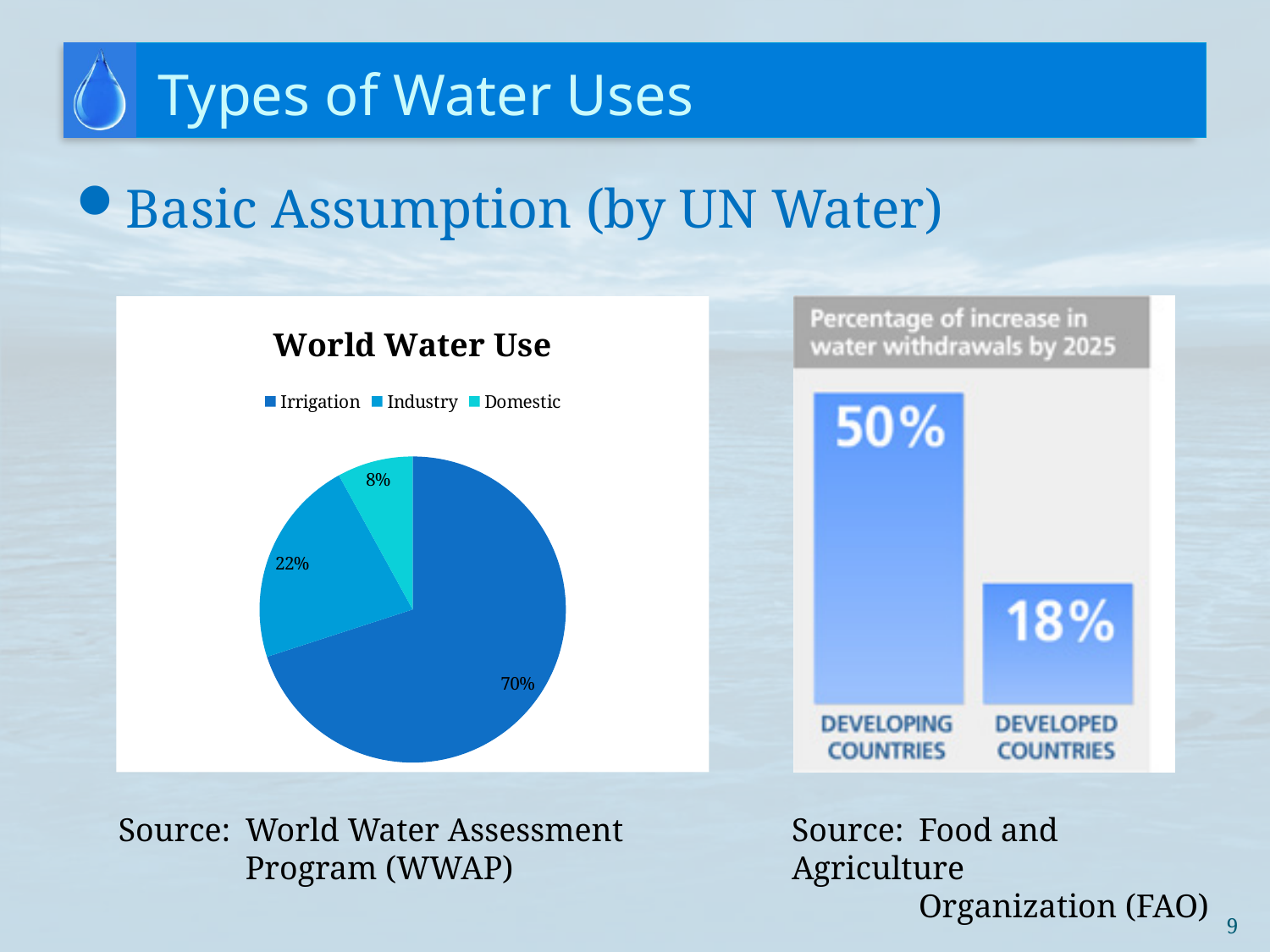
In the Percentage of increase in water withdrawals by 2025 chart, what is the difference between Developing Countries and Developed Countries? 32% In the World Water Use chart, what percentage of water use is Domestic? 8% What kind of chart is the Percentage of increase in water withdrawals by 2025 chart? Bar chart In the World Water Use chart, which category has the smallest share? Domestic In the World Water Use chart, which category has the largest share? Irrigation In the Percentage of increase in water withdrawals by 2025 chart, what is the value for Developed Countries? 18% In the World Water Use chart, how many categories does the legend list? 3 In the World Water Use chart, what percentage of water use is Irrigation? 70% In the World Water Use chart, what percentage of water use is Industry? 22% In the Percentage of increase in water withdrawals by 2025 chart, what is the value for Developing Countries? 50% What kind of chart is the World Water Use chart? Pie chart In the World Water Use chart, what is the difference between the Irrigation and Industry shares? 48%